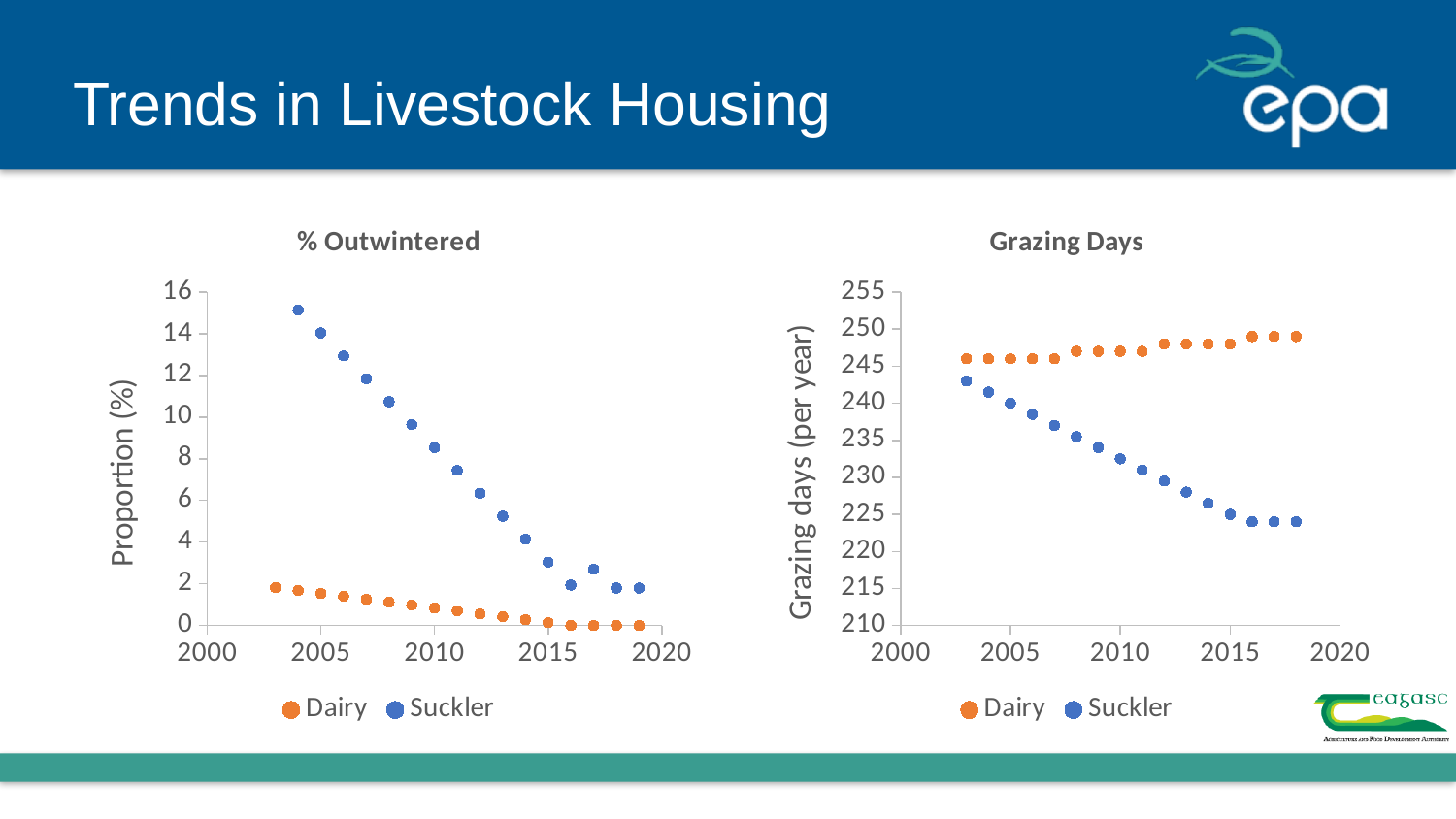
In the '% Outwintered' chart, is the Suckler value for 2015 greater or less than 4? less In the 'Grazing Days' chart, do the Dairy values rise or fall from 2003 to 2018? Rise In the 'Grazing Days' chart, which series has the larger value in 2015, Dairy or Suckler? Dairy In the 'Grazing Days' chart, do the Suckler values rise or fall over the years shown? Fall In the '% Outwintered' chart, do the Suckler values rise or fall from 2004 to 2019? Fall In the '% Outwintered' chart, is the Suckler value for 2005 greater or less than 12? greater In the 'Grazing Days' chart, is the Dairy value for 2018 greater or less than 245? greater In the '% Outwintered' chart, which series has the larger value in 2010, Dairy or Suckler? Suckler How many series does the legend of the 'Grazing Days' chart list? 2 What kind of chart is the '% Outwintered' chart? Scatter chart What is the y-axis label of the 'Grazing Days' chart? Grazing days (per year)